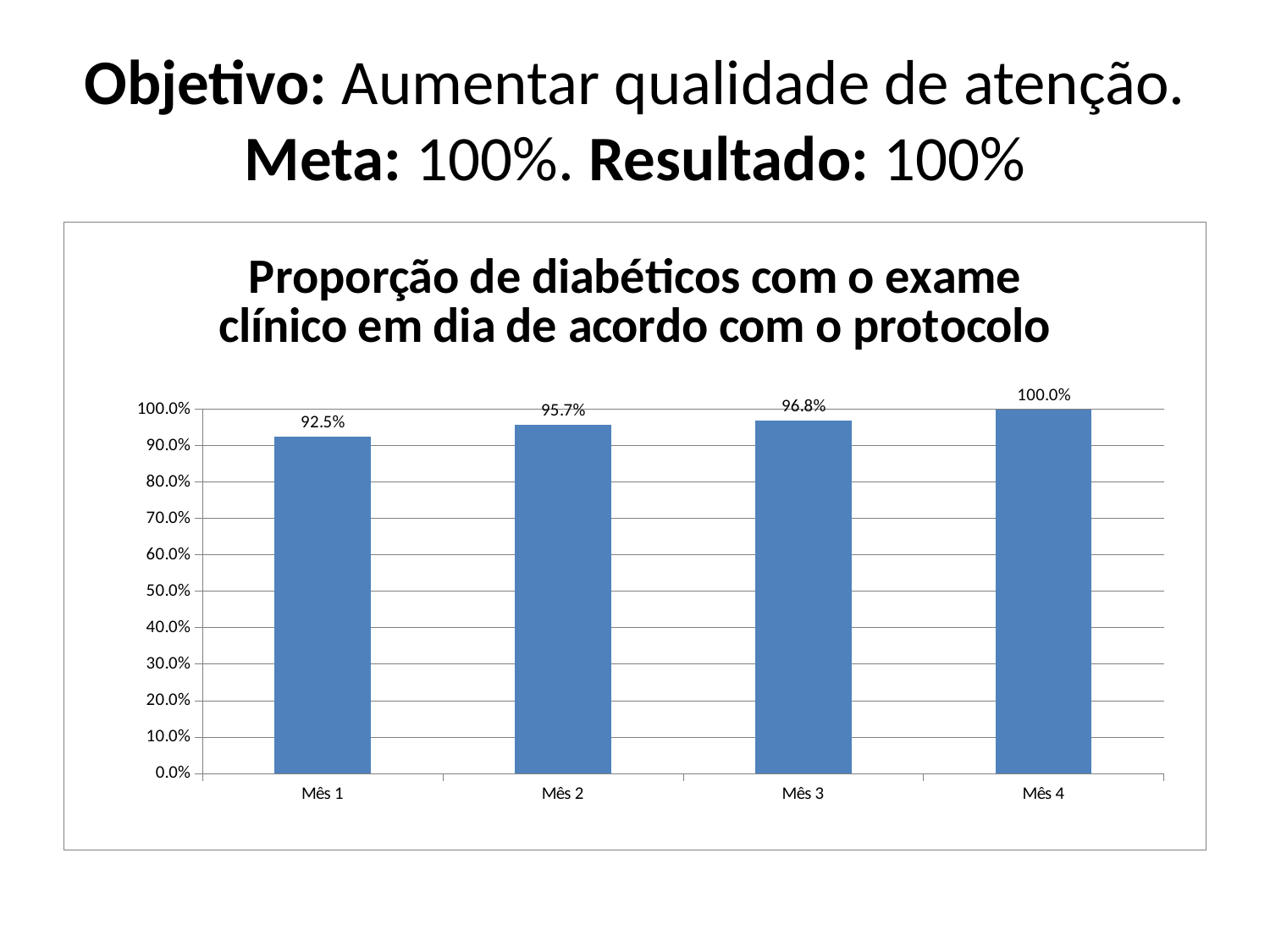
What is the value for Mês 3? 96.8% Which month has the highest value? Mês 4 What kind of chart is shown on the slide? Bar chart What is the value for Mês 1? 92.5% What is the value for Mês 2? 95.7% Is the value for Mês 1 greater or less than 90.0%? greater Which month has the lowest value? Mês 1 What is the value for Mês 4? 100.0% What is the difference between the values for Mês 4 and Mês 1? 7.5% How many months are shown on the x axis? 4 Do the values rise or fall from Mês 1 to Mês 4? Rise Which is larger, the value for Mês 2 or the value for Mês 3? Mês 3